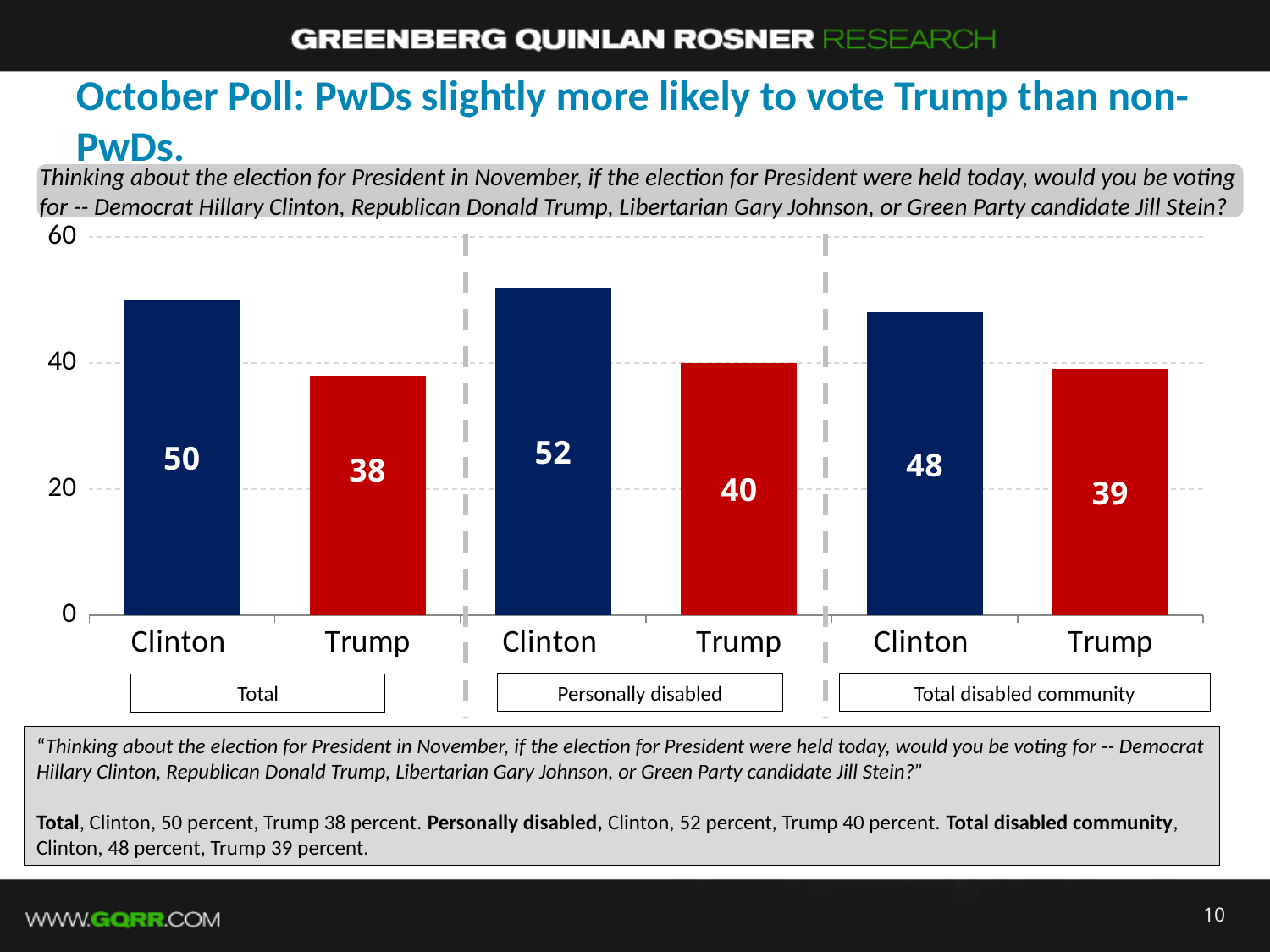
Which bar has the lowest value on the chart? Trump, Total Which bar has the highest value on the chart? Clinton, Personally disabled What is the value for Clinton in the Total group? 50 How many bars are plotted on the chart? 6 What is the value for Trump in the Total group? 38 What kind of chart is shown on the slide? Bar chart What is the value for Clinton in the Total disabled community group? 48 What is the value for Trump in the Personally disabled group? 40 What is the difference between Clinton and Trump in the Personally disabled group? 12 What colour are the Trump bars? Red What is the difference between Clinton and Trump in the Total disabled community group? 9 Which is larger: Trump in the Total group or Trump in the Personally disabled group? Trump in the Personally disabled group